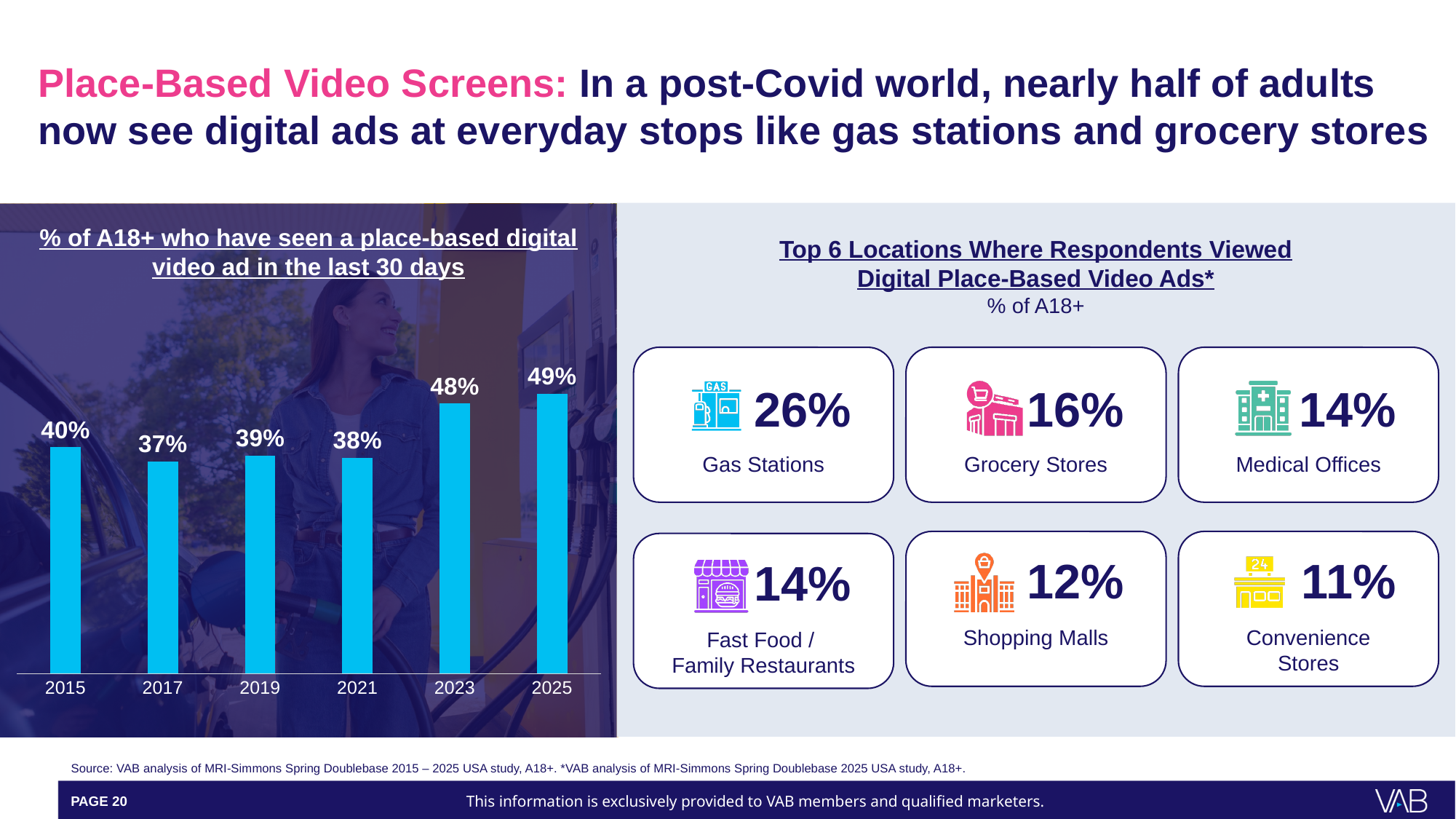
Which year has the highest value in the bar chart? 2025 What percentage of A18+ had seen a place-based digital video ad in the last 30 days in 2015? 40% What is the difference between the 2023 value and the 2021 value in the bar chart? 10 percentage points What kind of chart is used to show the % of A18+ who have seen a place-based digital video ad? Bar chart What is the title of the bar chart on the left of the slide? % of A18+ who have seen a place-based digital video ad in the last 30 days What is the difference between the 2025 value and the 2015 value in the bar chart? 9 percentage points What is the value shown for 2023 in the bar chart? 48% What is the value shown for 2021 in the bar chart? 38% Which year has the lowest value in the bar chart? 2017 Which is larger in the bar chart, the value for 2019 or the value for 2021? 2019 Overall, do the values in the bar chart rise or fall from 2015 to 2025? Rise How many years are plotted in the bar chart? 6